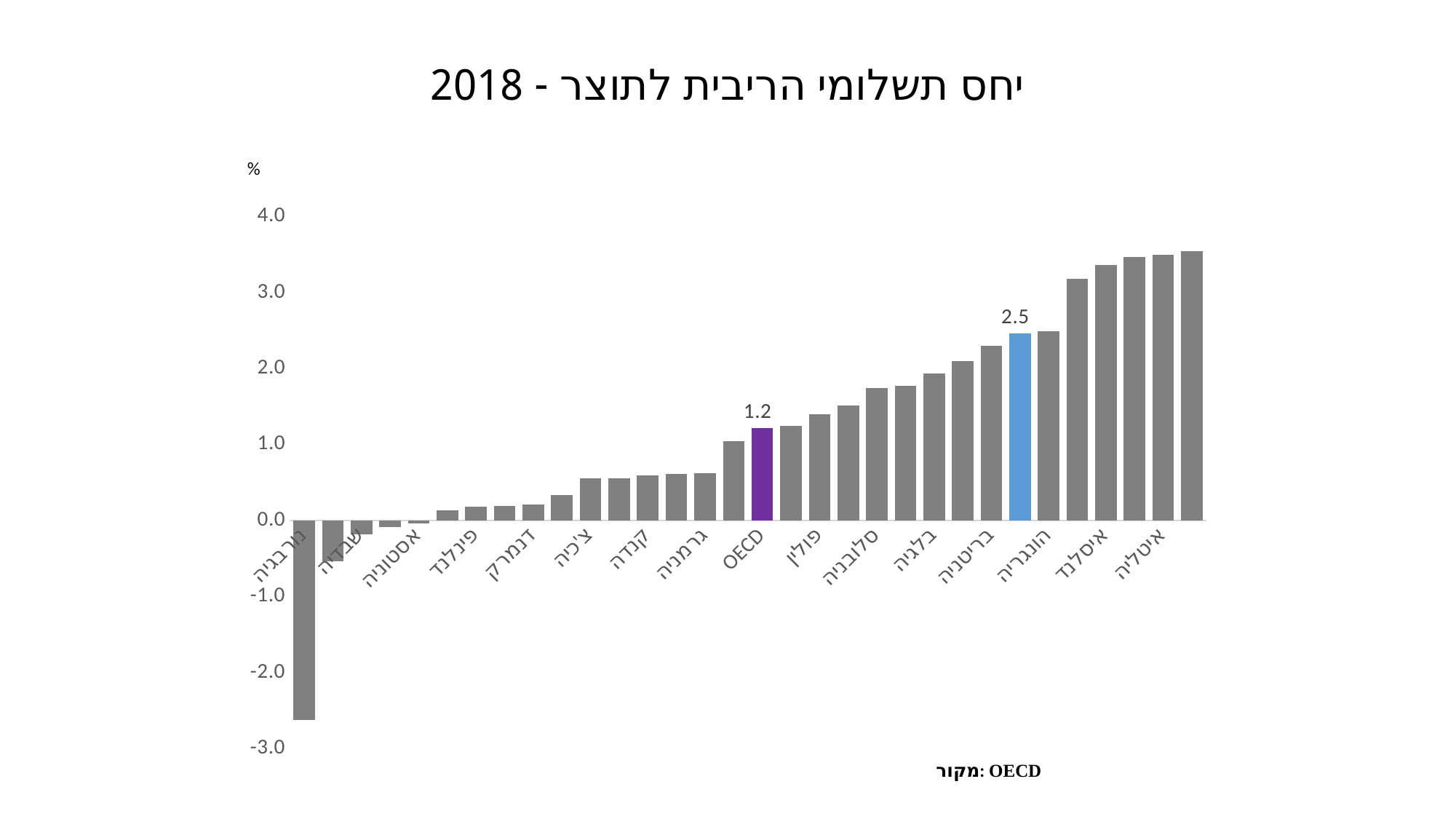
Which is larger, the value for גרמניה or the value for פולין? פולין Is the value for קנדה greater or less than 1.0? less Which is larger, the value for צ'כיה or the value for בריטניה? בריטניה Is the value for נורבגיה greater or less than -2.0? less What kind of chart is shown on the slide? bar chart What is the value for OECD? 1.2 What is the title of the chart? יחס תשלומי הריבית לתוצר - 2018 Do the values rise or fall moving from left to right along the x axis? rise Is the value for איטליה greater or less than 3.0? greater Which labelled country has the lowest value? נורבגיה